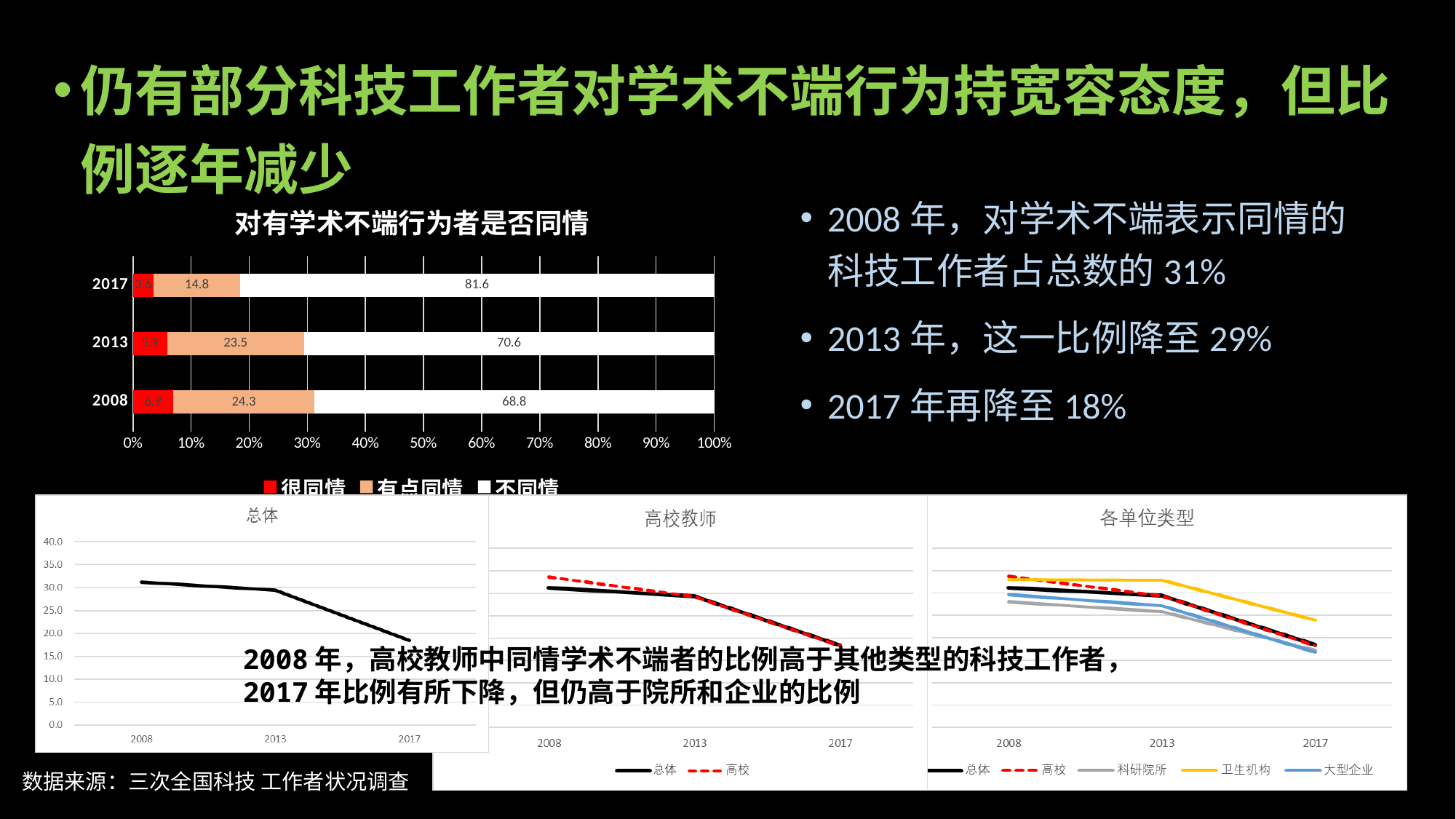
In the line chart titled 总体, do the values rise or fall from 2008 to 2017? Fall In the line chart titled 总体, is the value for 2017 greater or less than 25.0? less In the chart titled 对有学术不端行为者是否同情, is the 有点同情 value larger for 2013 or for 2017? 2013 In the chart titled 对有学术不端行为者是否同情, what is the difference between the 不同情 values for 2017 and 2008? 12.8 In the line chart titled 各单位类型, how many series does the legend list? 5 In the chart titled 对有学术不端行为者是否同情, which year has the highest value for 很同情? 2008 In the chart titled 对有学术不端行为者是否同情, how many series does the legend list? 3 In the chart titled 对有学术不端行为者是否同情, what is the value of 不同情 for 2017? 81.6 In the chart titled 对有学术不端行为者是否同情, what is the value of 有点同情 for 2008? 24.3 In the chart titled 对有学术不端行为者是否同情, what is the value of 很同情 for 2013? 5.9 In the chart titled 对有学术不端行为者是否同情, which year has the lowest value for 有点同情? 2017 What kind of chart is the chart titled 对有学术不端行为者是否同情? Stacked bar chart